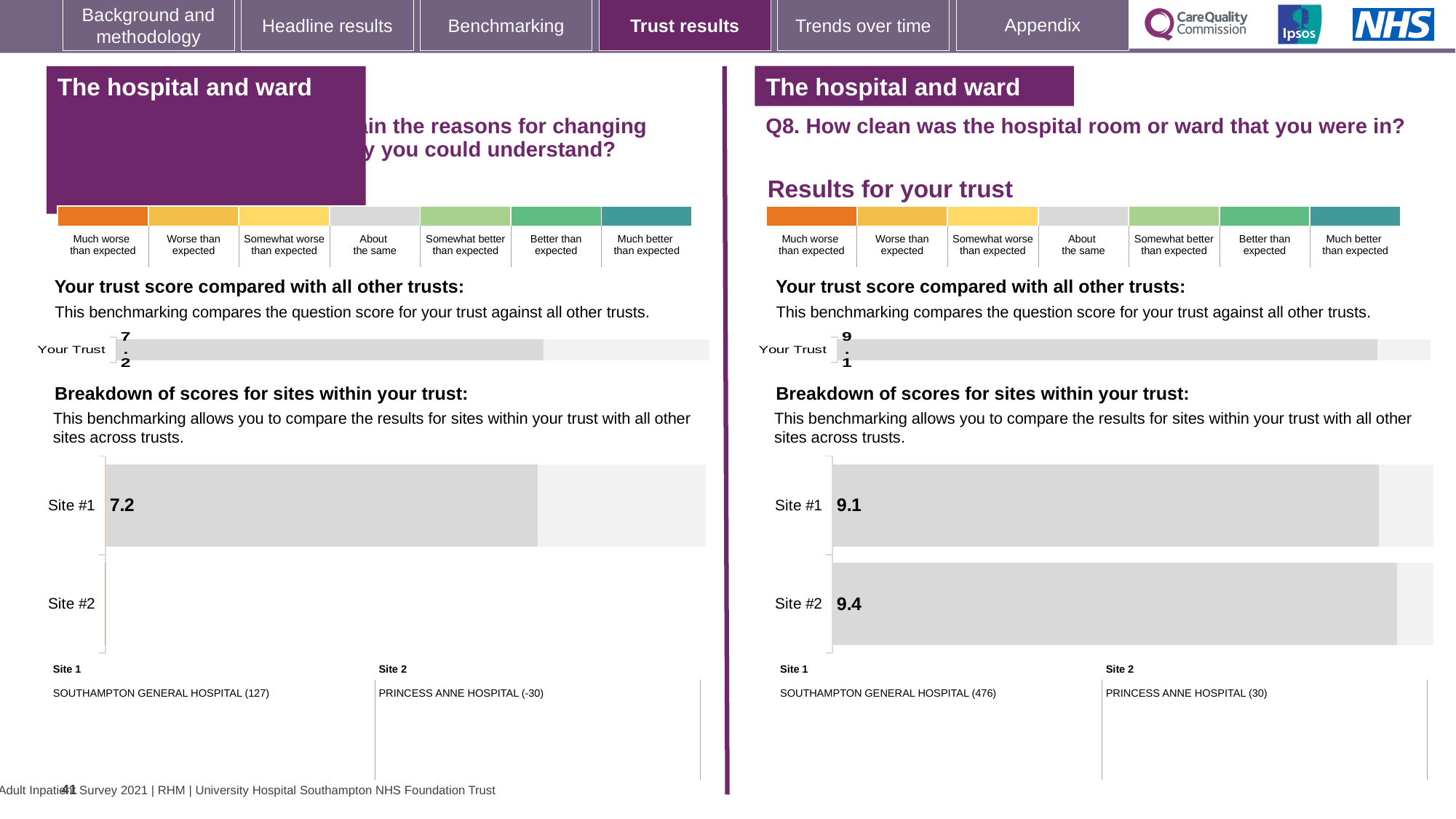
On the right-hand Q8 breakdown chart, what is the difference between the Site #2 and Site #1 scores? 0.3 On the right-hand Q8 breakdown chart, what is the score for Site #2? 9.4 On the left-hand breakdown chart, how many sites are listed? 2 Which hospital is listed as Site 1 on the right-hand side of the slide? Southampton General Hospital What type of chart is used for the breakdown of scores for sites on the right-hand side? Bar chart On the right-hand Q8 breakdown chart, what is the score for Site #1? 9.1 On the left-hand breakdown chart, what is the score for Site #1? 7.2 On the right-hand Q8 chart (How clean was the hospital room or ward), what is the score shown for Your Trust? 9.1 On the right-hand Q8 breakdown chart, which site has the higher score? Site #2 Which hospital is listed as Site 2 on the right-hand side of the slide? Princess Anne Hospital On the left-hand chart, what is the score shown for Your Trust? 7.2 On the right-hand Q8 breakdown chart, is the Site #1 score larger or smaller than the Site #2 score? Smaller